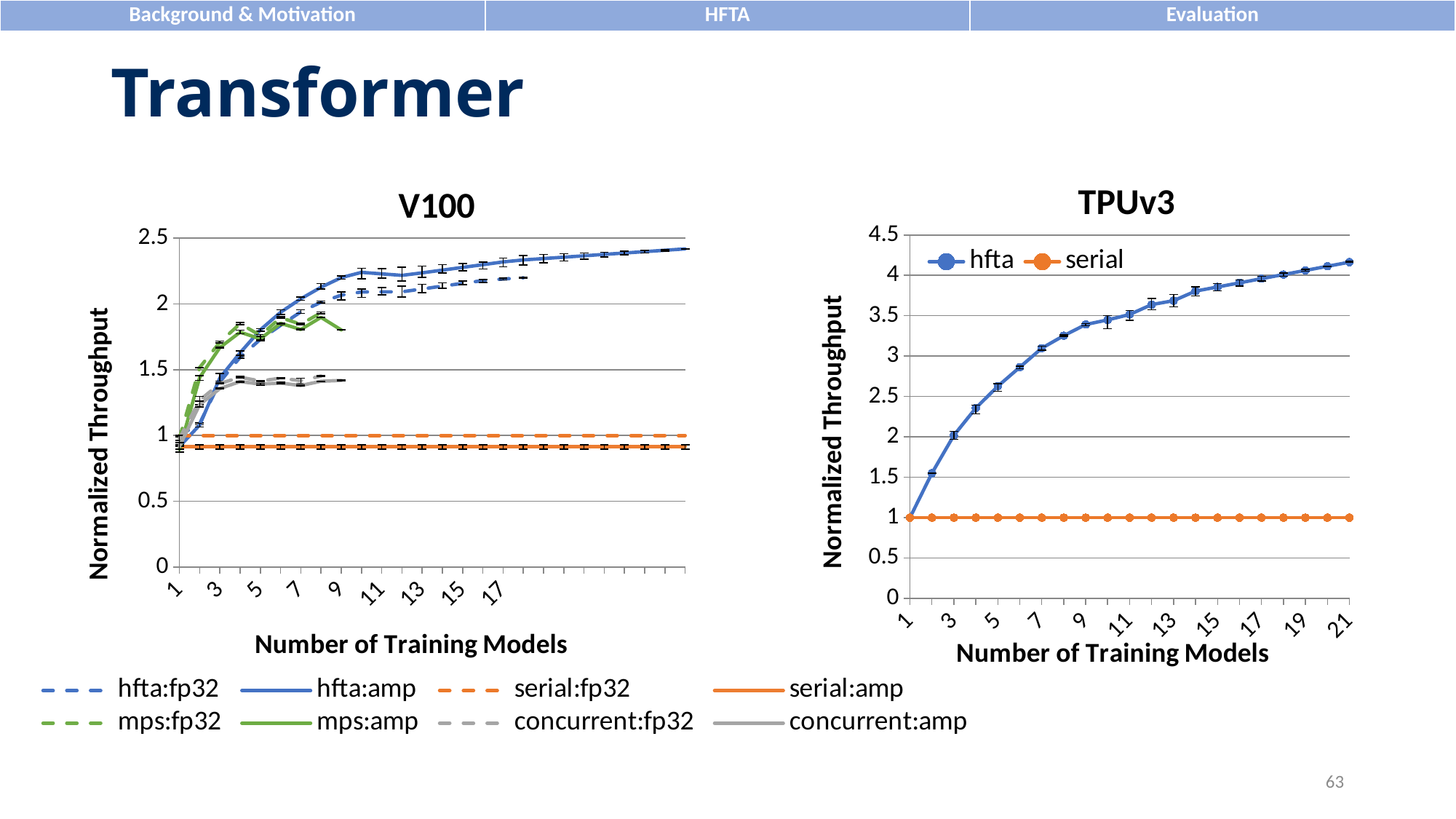
How many series does the legend list for the TPUv3 chart? 2 How many series does the legend list for the V100 chart? 8 In the TPUv3 chart, does the hfta series rise or fall as the number of training models increases? rise In the V100 chart, is the value for concurrent:amp at 9 training models greater or less than 1.5? less In the TPUv3 chart, which series is higher at 9 training models, hfta or serial? hfta In the V100 chart, which is higher at 7 training models, mps:amp or concurrent:amp? mps:amp In the V100 chart, is the value for hfta:amp at 17 training models greater or less than 2? greater What is the x-axis label of the TPUv3 chart? Number of Training Models In the V100 chart, which is higher at 13 training models, hfta:amp or hfta:fp32? hfta:amp What kind of chart is the V100 chart? line chart In the TPUv3 chart, is the value for hfta at 21 training models greater or less than 4? greater In the V100 chart, does the hfta:amp series rise or fall as the number of training models increases? rise